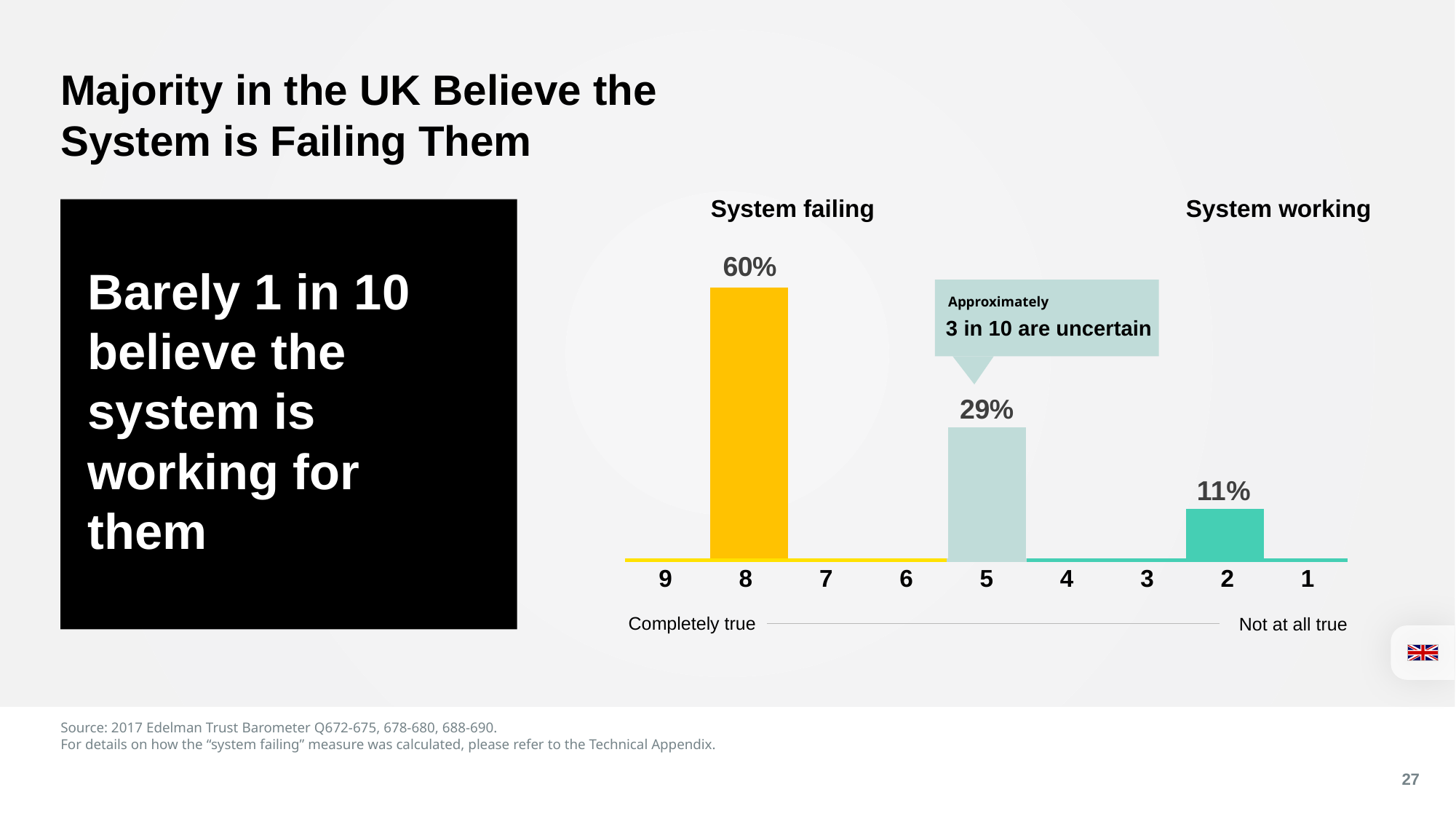
Which category has the highest value? 8 What label appears above the left side of the chart? System failing Which is larger, the value for category 8 or the value for category 2? category 8 What is the difference between the values for category 8 and category 5? 31% What is the value shown for category 2? 11% How many categories are labelled along the x axis? 9 What is the value shown for category 8? 60% What kind of chart is shown on the slide? bar chart What label appears at the right end of the x axis below the categories? Not at all true What is the value shown for category 5? 29% What is the difference between the values for category 5 and category 2? 18% Which of the three labelled bars has the lowest value? 2